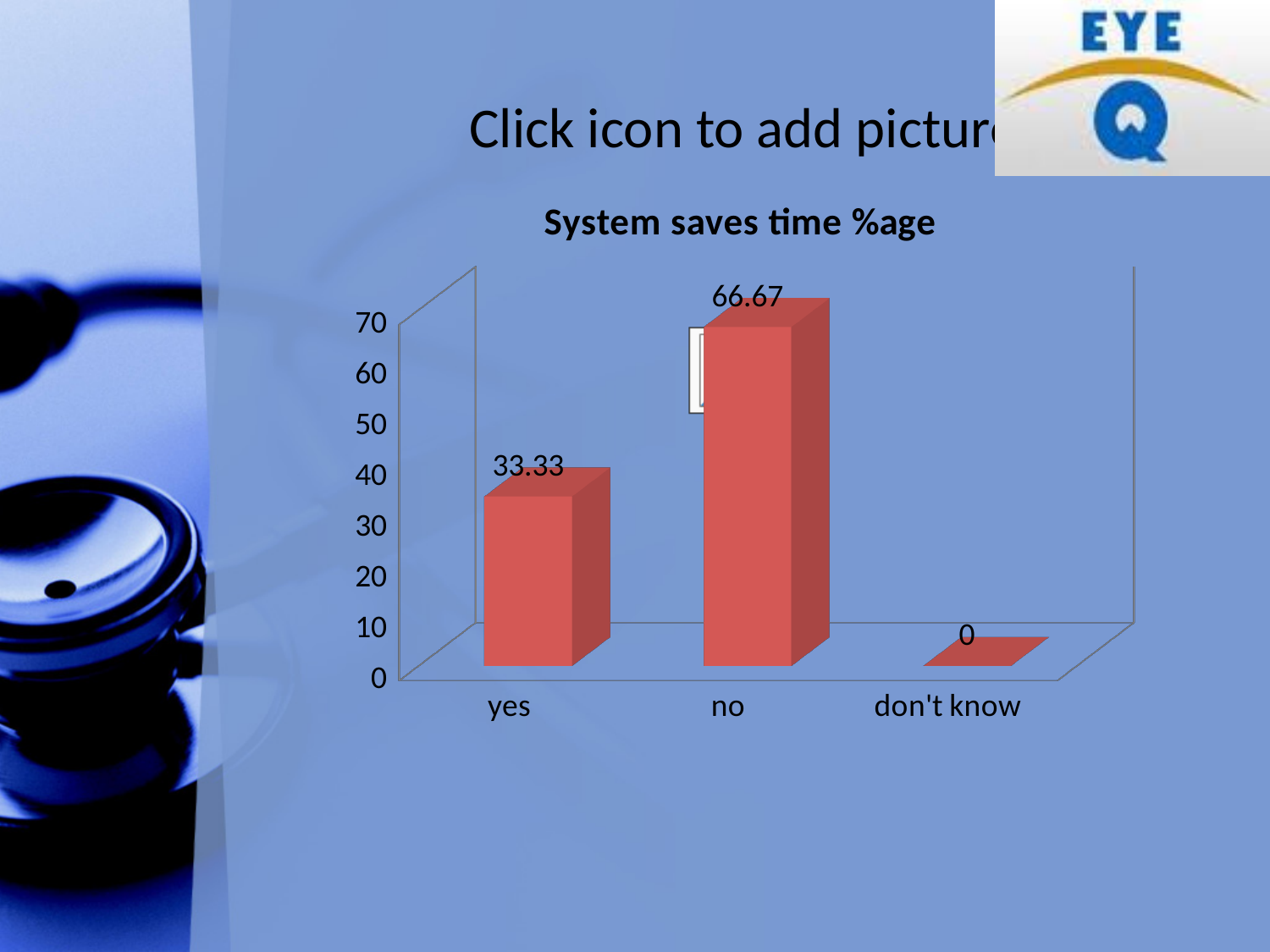
What is the value for "no"? 66.67 Is the value for "yes" greater or less than 40? less What is the title of the chart? System saves time %age Which category has the highest value? no Which category has the lowest value? don't know Is the value for "no" greater or less than 60? greater What is the value for "don't know"? 0 What is the value for "yes"? 33.33 What is the difference between the values for "no" and "yes"? 33.34 How many categories are shown on the x axis? 3 Which is larger, the value for "yes" or the value for "no"? no What kind of chart is shown? bar chart